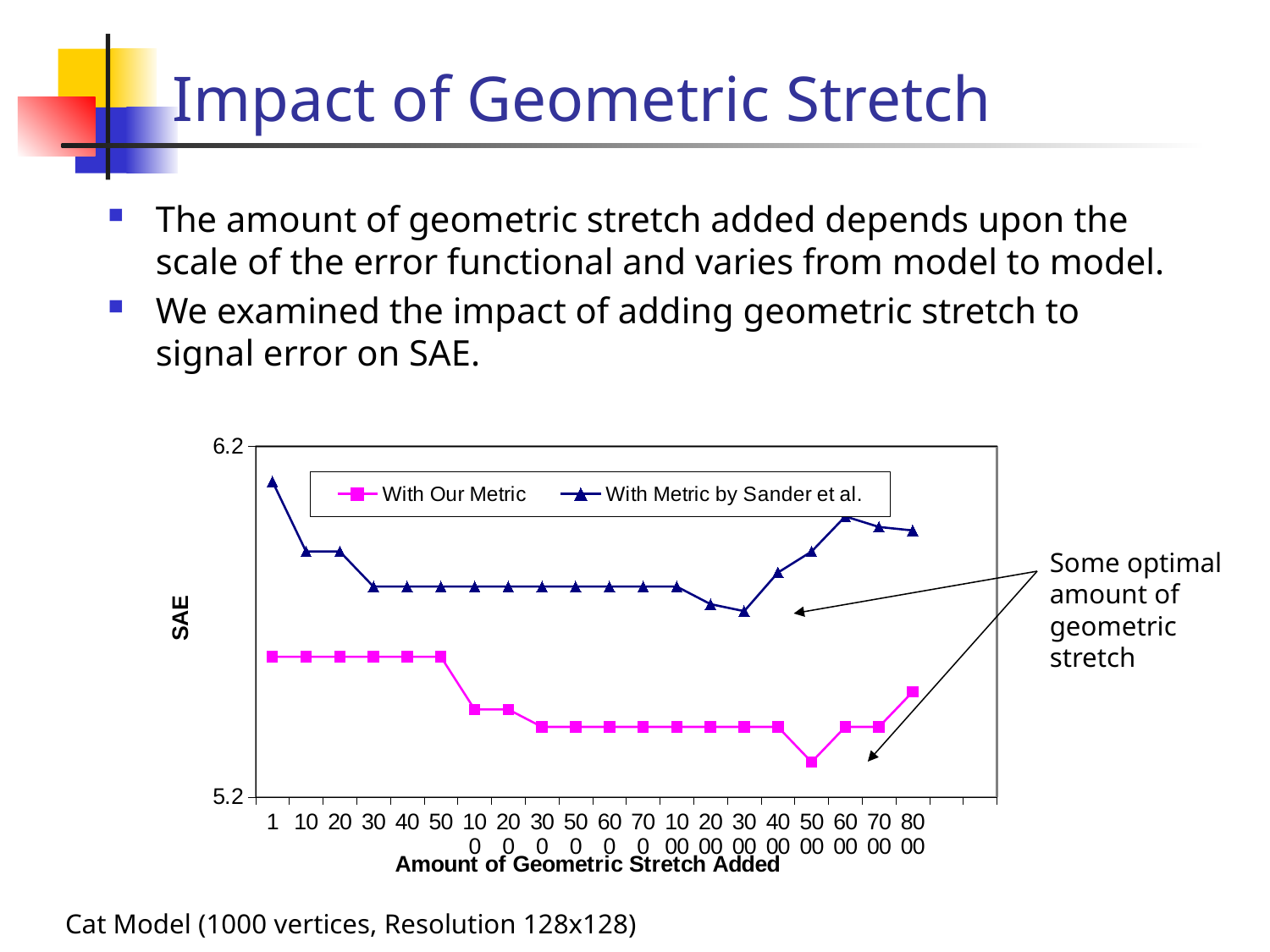
How many series does the chart's legend list? 2 Is the SAE value for With Metric by Sander et al. at stretch amount 1 greater or less than 5.2? greater At which amount of geometric stretch does the With Metric by Sander et al. series reach its highest SAE? 1 What kind of chart is shown on the slide? Line chart Is the SAE value for With Our Metric at stretch amount 5000 greater or less than 6.2? less Does the SAE for With Metric by Sander et al. rise or fall as the stretch amount goes from 1 to 30? Fall What is the title of the chart's x axis? Amount of Geometric Stretch Added How many data points are plotted along the x axis for each series? 20 Does the SAE for With Our Metric rise or fall as the stretch amount goes from 5000 to 8000? Rise Which series has the higher SAE values across the chart, With Our Metric or With Metric by Sander et al.? With Metric by Sander et al. At which amount of geometric stretch does the With Our Metric series reach its lowest SAE? 5000 What are the two series named in the chart's legend? With Our Metric; With Metric by Sander et al.